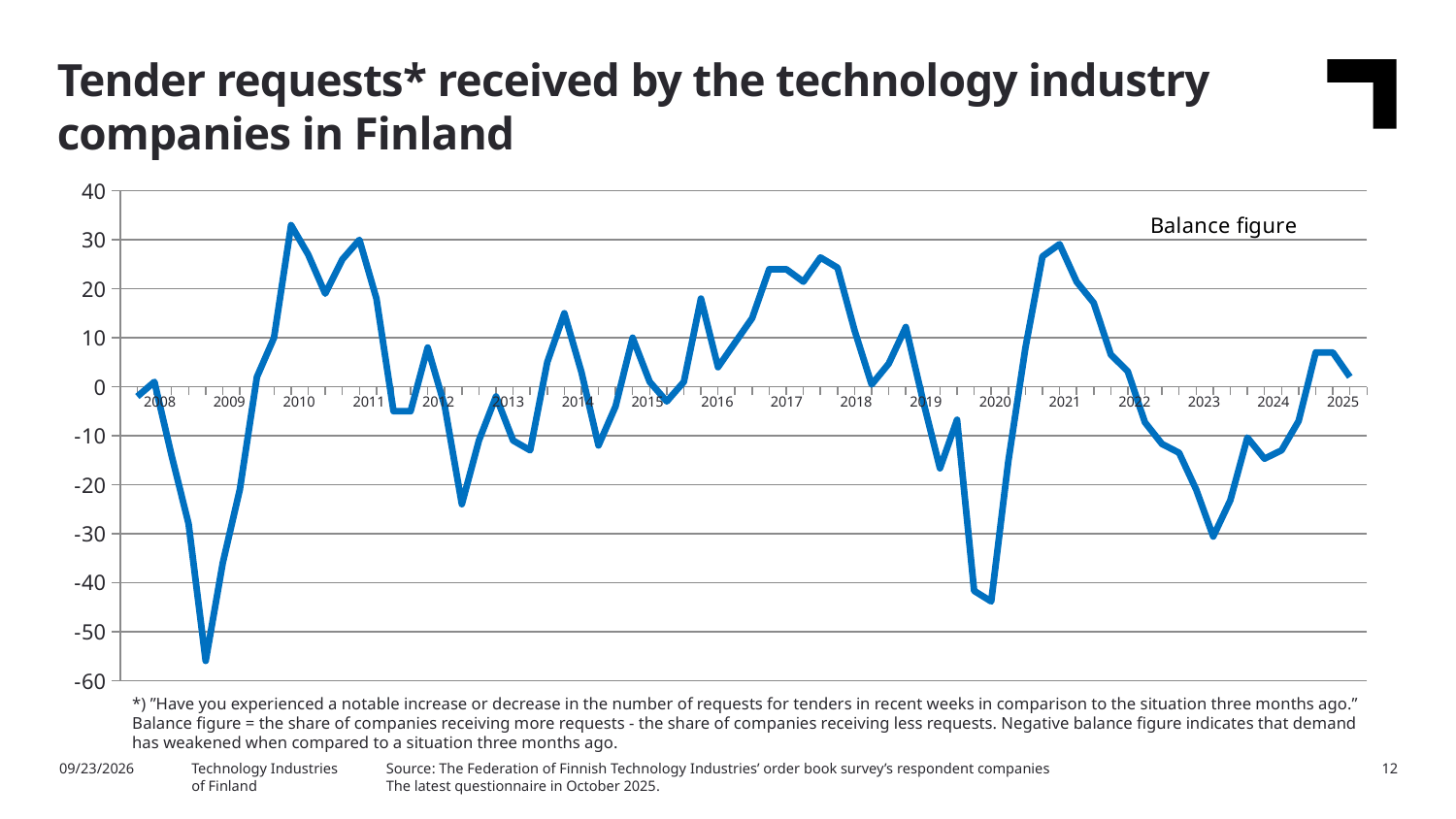
What is the title of the chart? Tender requests* received by the technology industry companies in Finland How many years are labelled on the x axis? 18 What label is shown in the chart's legend? Balance figure Is the peak value of the line in 2010 greater or less than 30? greater What kind of chart is shown on the slide? line chart Do the values rise or fall along the x axis from the 2021 peak to 2023? fall Is the low point of the line in 2012 greater or less than -20? less Is the peak value of the line in 2021 greater or less than 20? greater Which is lower, the low point of the line in 2009 or the low point in 2020? 2009 In which year does the line reach its lowest value? 2009